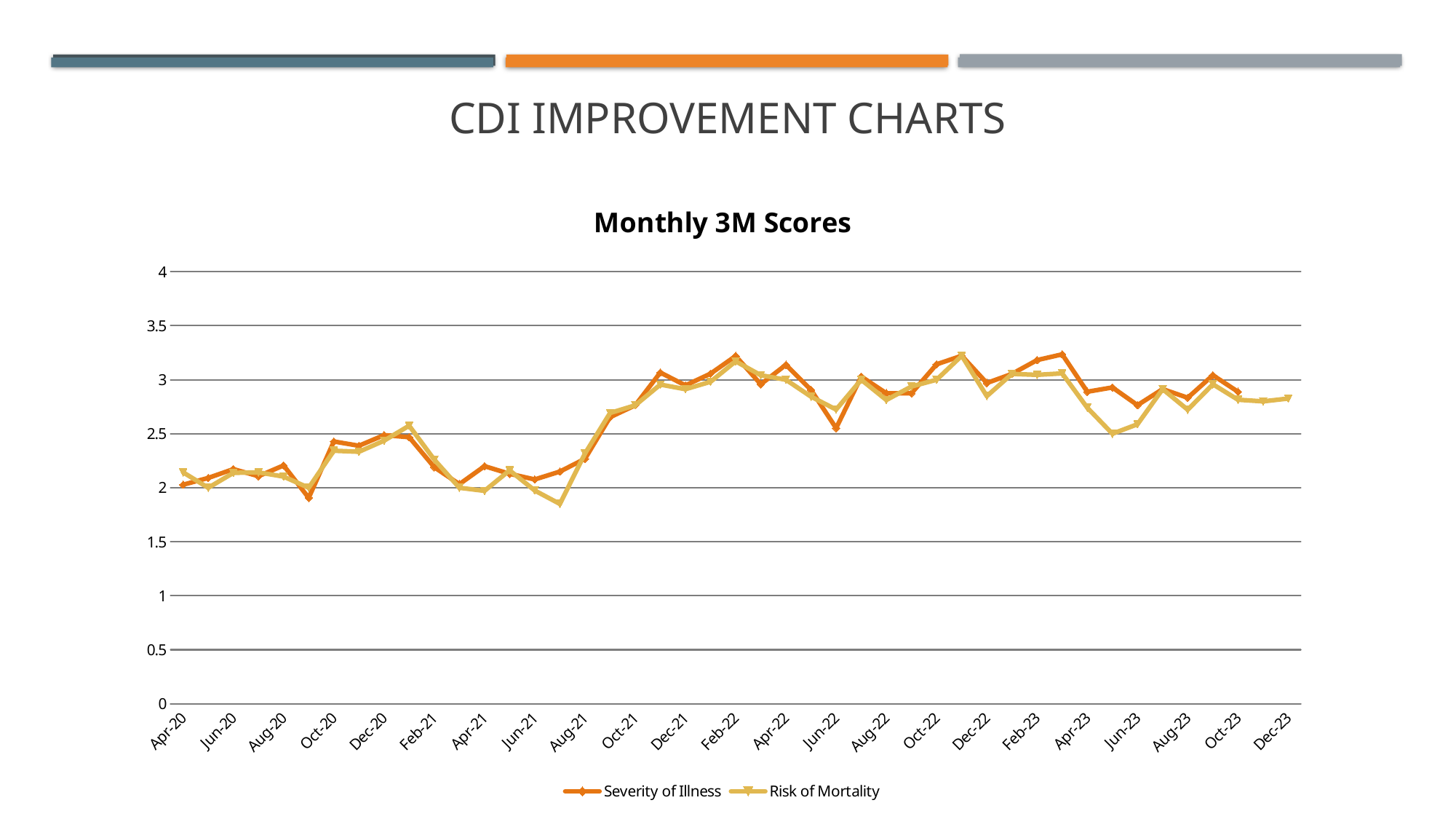
What type of chart is shown on the slide? Line chart Is the Severity of Illness value for Feb-23 greater or less than 3? greater Is the Risk of Mortality value for Jun-22 greater or less than 2.5? greater How many series does the legend list? 2 Which series is drawn in the darker orange line? Severity of Illness Overall, do the scores rise or fall from Apr-20 to Dec-23? rise Is the Severity of Illness value for Aug-21 greater or less than 2.5? less What is the title of the chart? Monthly 3M Scores At Jun-22, which series has the higher value, Severity of Illness or Risk of Mortality? Risk of Mortality